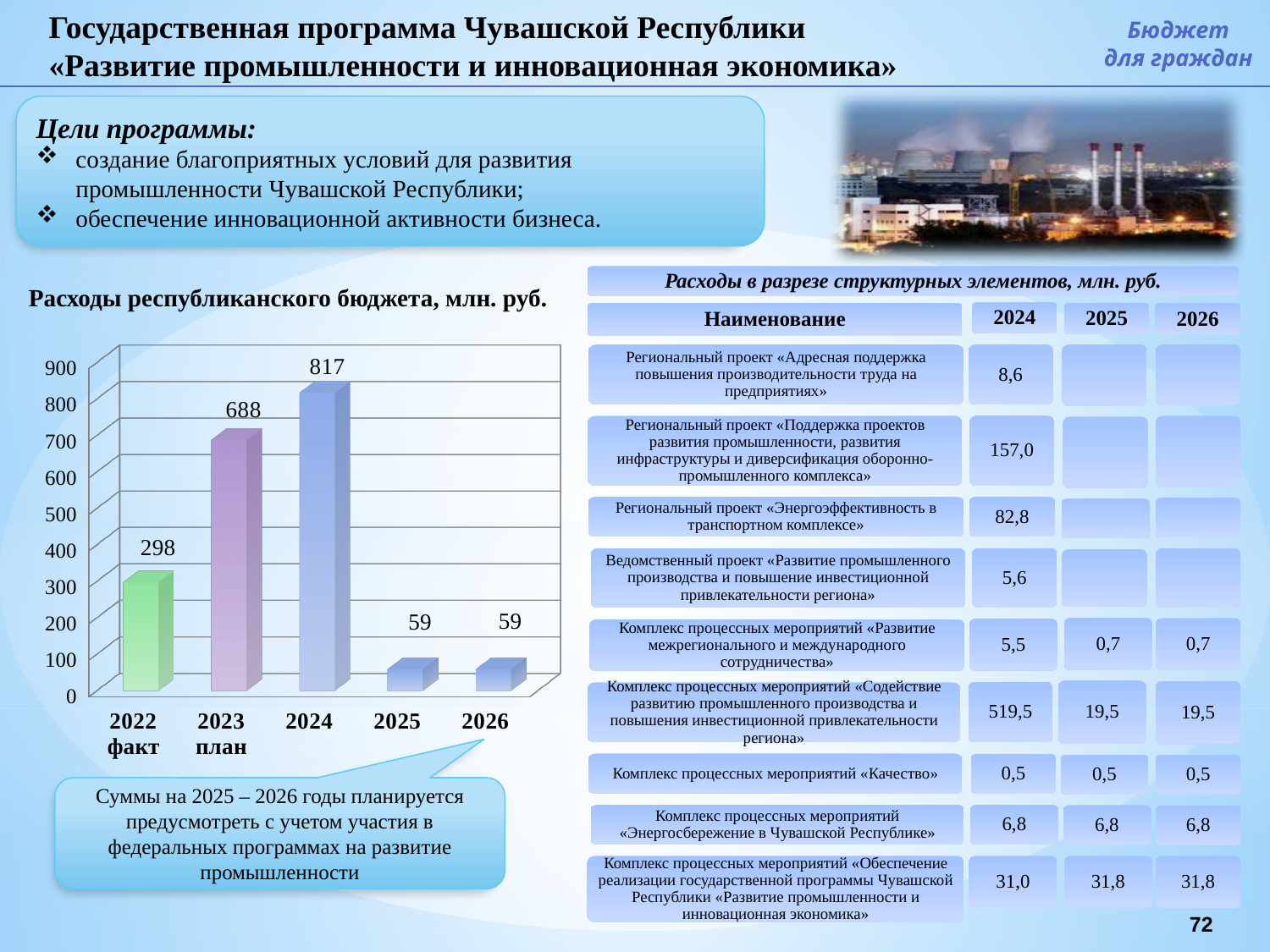
How many categories are shown on the x axis of the chart? 5 What is the difference between the values for 2024 and 2023 план? 129 What is the difference between the values for 2023 план and 2022 факт? 390 What is the value for 2024 in the chart "Расходы республиканского бюджета, млн. руб."? 817 What is the value for 2026 in the chart? 59 Which is larger, the value for 2022 факт or the value for 2025? 2022 факт What is the title of the chart on the slide? Расходы республиканского бюджета, млн. руб. What is the value for 2023 план in the chart? 688 What is the value for 2022 факт in the chart? 298 What kind of chart is shown on the slide? bar chart Which year has the highest value in the chart? 2024 Is the value for 2023 план greater or less than 600? greater